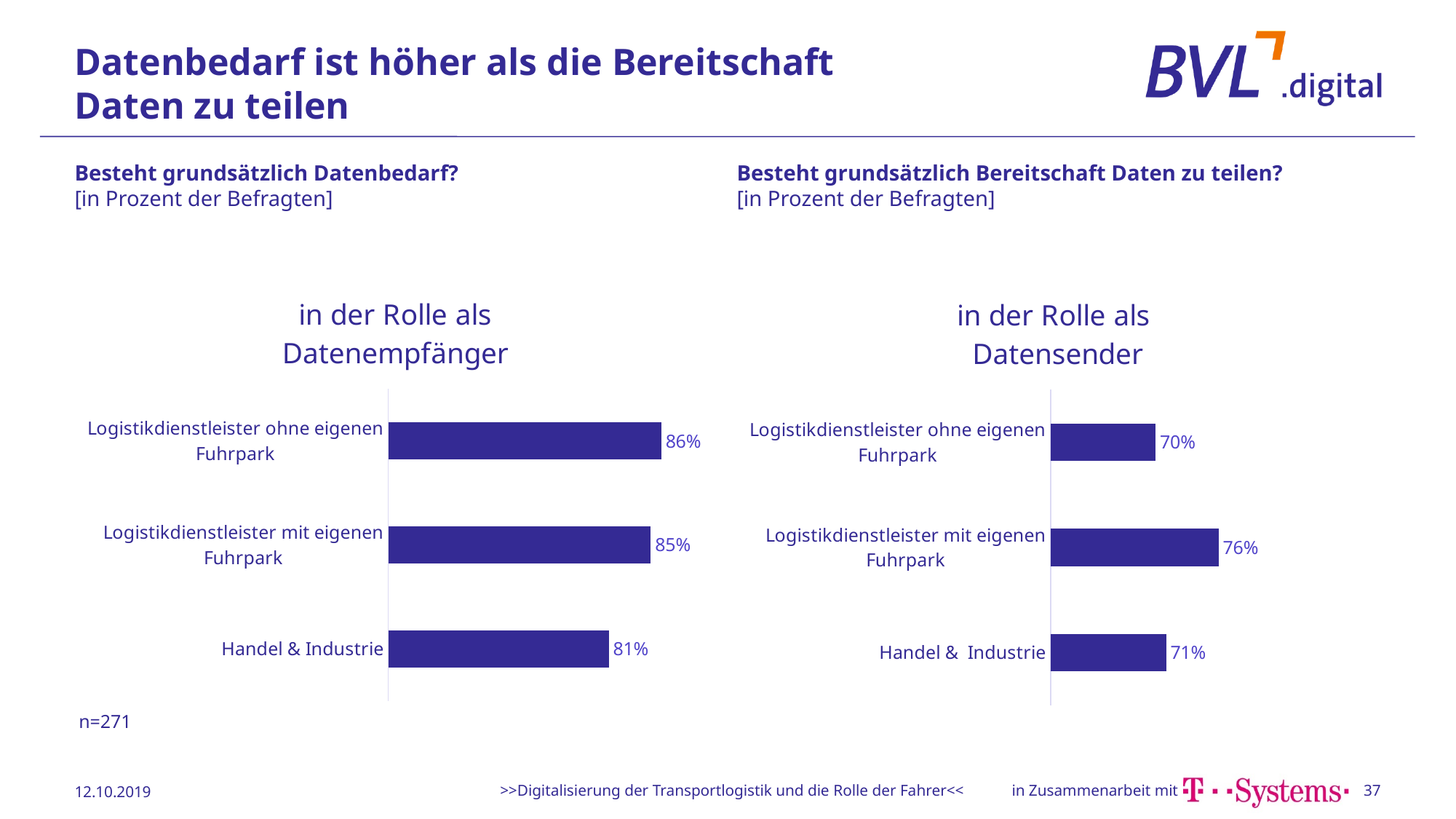
In the left chart (in der Rolle als Datenempfänger), what is the difference between Logistikdienstleister ohne eigenen Fuhrpark and Handel & Industrie? 5% How many categories does the left chart (in der Rolle als Datenempfänger) show? 3 In the right chart (in der Rolle als Datensender), which category has the highest value? Logistikdienstleister mit eigenen Fuhrpark In the left chart (in der Rolle als Datenempfänger), which category has the lowest value? Handel & Industrie In the left chart (in der Rolle als Datenempfänger), what is the value for Logistikdienstleister ohne eigenen Fuhrpark? 86% In the right chart (in der Rolle als Datensender), which is larger: Logistikdienstleister mit eigenen Fuhrpark or Handel & Industrie? Logistikdienstleister mit eigenen Fuhrpark In the right chart (in der Rolle als Datensender), what is the value for Handel & Industrie? 71% In the right chart (in der Rolle als Datensender), what is the value for Logistikdienstleister mit eigenen Fuhrpark? 76% In the right chart (in der Rolle als Datensender), which category has the lowest value? Logistikdienstleister ohne eigenen Fuhrpark In the left chart (in der Rolle als Datenempfänger), what is the value for Handel & Industrie? 81% What kind of chart is the right chart (in der Rolle als Datensender)? Bar chart What is the difference between the value for Logistikdienstleister ohne eigenen Fuhrpark in the left chart (Datenempfänger) and in the right chart (Datensender)? 16%